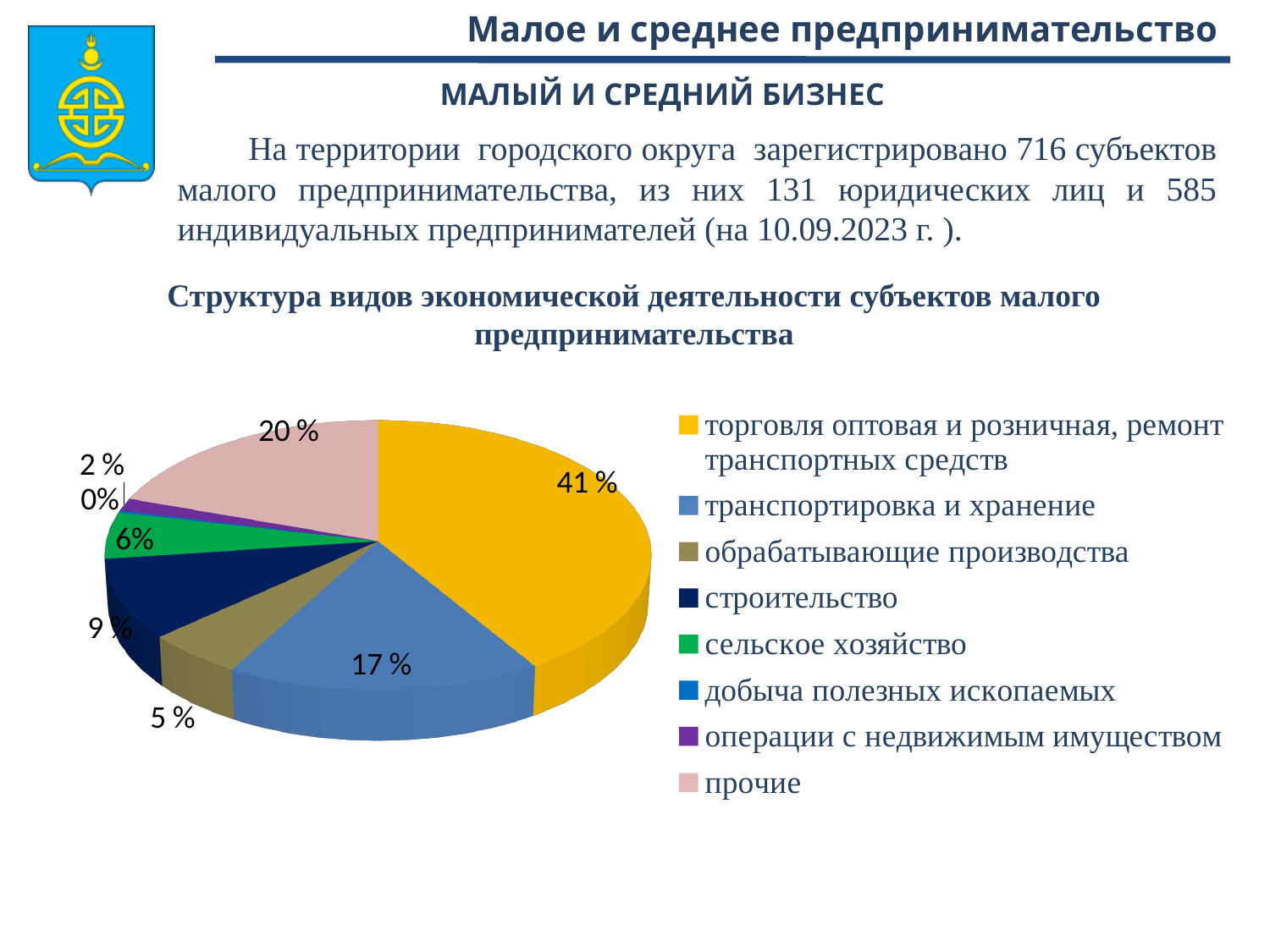
Which category has the largest slice of the pie? торговля оптовая и розничная, ремонт транспортных средств Which category has the smallest slice of the pie? добыча полезных ископаемых What share of the pie does "строительство" have? 9 % Which is larger: the share of "строительство" or the share of "обрабатывающие производства"? строительство What share of the pie does "прочие" have? 20 % What kind of chart is shown on the slide? pie chart What is the difference between the shares of "торговля оптовая и розничная, ремонт транспортных средств" and "прочие"? 21 % What share of the pie does "торговля оптовая и розничная, ремонт транспортных средств" have? 41 % What is the title of the chart? Структура видов экономической деятельности субъектов малого предпринимательства What share of the pie does "транспортировка и хранение" have? 17 % How many categories does the legend list? 8 What share of the pie does "сельское хозяйство" have? 6%